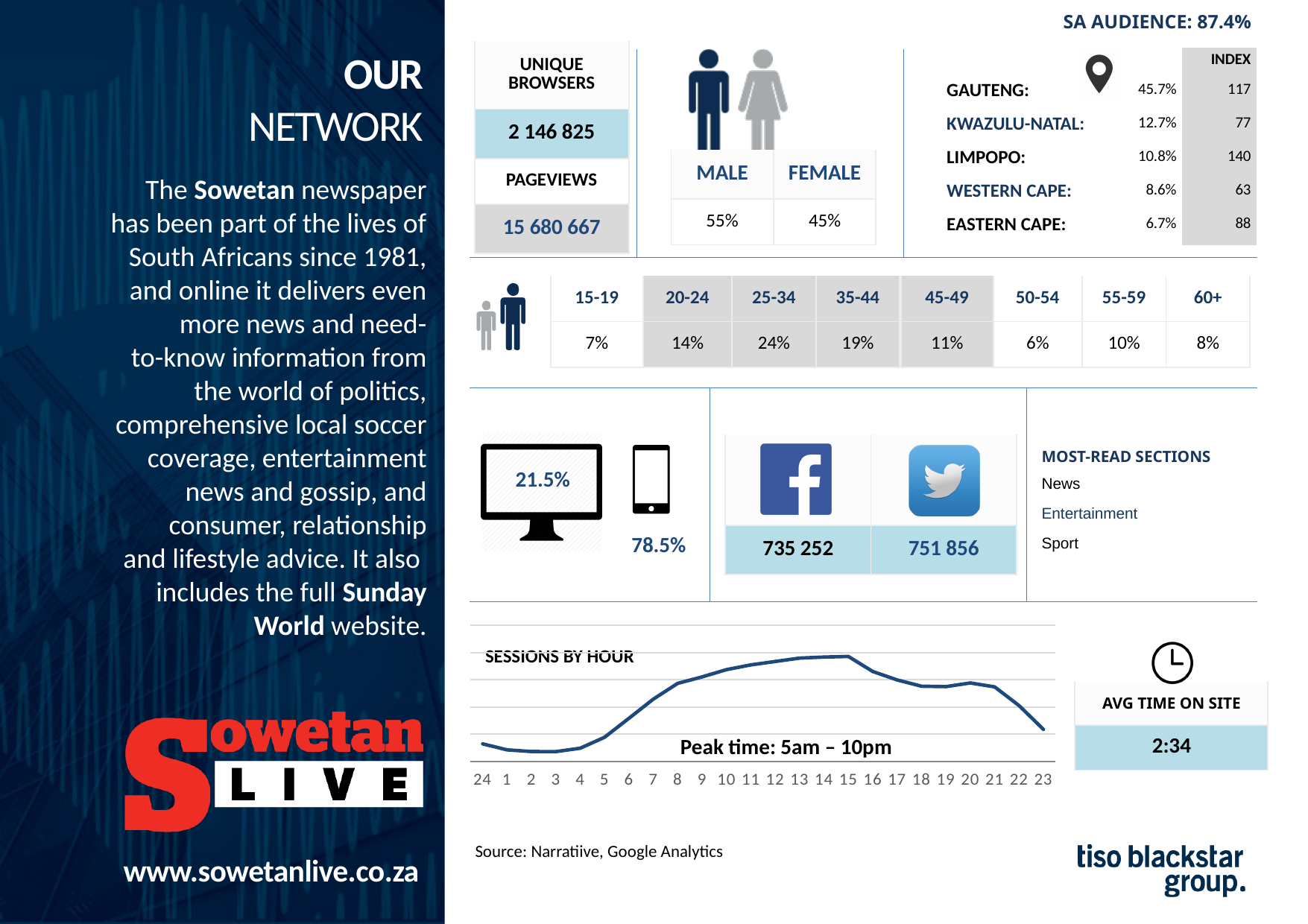
How many hour points are labelled on the x axis of the "Sessions by hour" chart? 24 What is the title of the line chart at the bottom of the slide? Sessions by hour In the "Sessions by hour" chart, do sessions rise or fall between hour 15 and hour 23? fall In the "Sessions by hour" chart, which has more sessions, hour 15 or hour 1? hour 15 What peak time is annotated on the "Sessions by hour" chart? 5am – 10pm In the "Sessions by hour" chart, do sessions rise or fall between hour 3 and hour 15? rise What is the first hour label on the x axis of the "Sessions by hour" chart? 24 What kind of chart is the "Sessions by hour" chart? line chart In the "Sessions by hour" chart, which has more sessions, hour 3 or hour 8? hour 8 In the "Sessions by hour" chart, which has more sessions, hour 20 or hour 23? hour 20